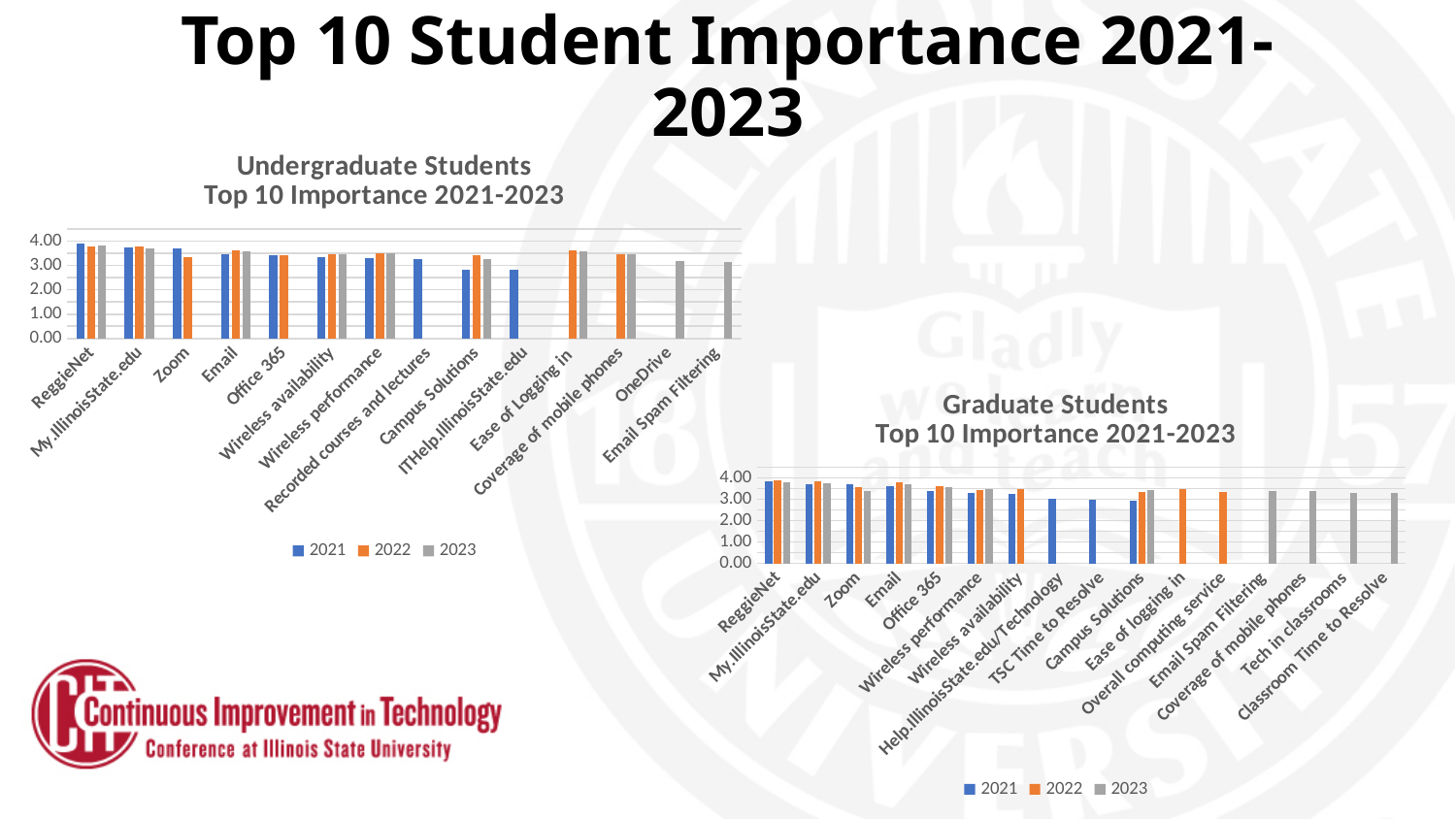
What is the title of the chart on the right side of the slide? Graduate Students Top 10 Importance 2021-2023 What are the series names listed in the legend of the Undergraduate Students chart? 2021, 2022, 2023 In the Graduate Students chart, is the 2023 value for Classroom Time to Resolve greater or less than 2.00? greater In the Graduate Students chart, is the 2022 value for ReggieNet greater or less than 3.00? greater What kind of chart is the Undergraduate Students Top 10 Importance 2021-2023 chart? bar chart How many series does the legend of the Graduate Students Top 10 Importance 2021-2023 chart list? 3 In the Undergraduate Students chart, how many categories are shown on the x axis? 14 In the Undergraduate Students chart, is the 2021 value for ITHelp.IllinoisState.edu greater or less than 3.00? less In the Graduate Students chart, how many categories are shown on the x axis? 16